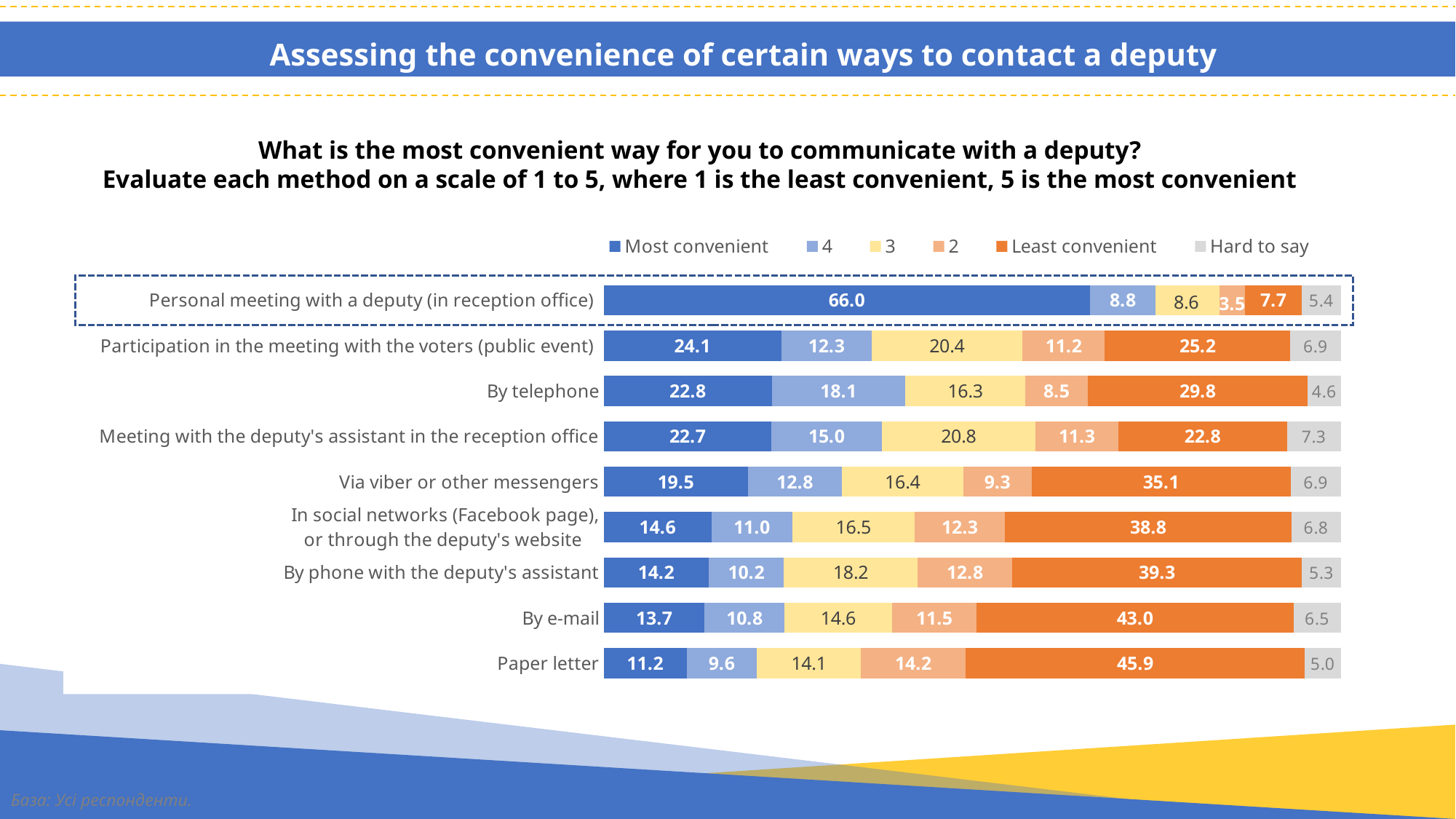
What is the value of the "3" series for "Via viber or other messengers"? 16.4 Which has a larger value for the "4" series: "By telephone" or "Meeting with the deputy's assistant in the reception office"? By telephone What is the "Hard to say" value for "By telephone"? 4.6 How many series does the legend list? 6 What kind of chart is shown on the slide? Stacked bar chart What is the "Most convenient" value for "Personal meeting with a deputy (in reception office)"? 66.0 How many contact methods are shown in the chart? 9 What is the "Least convenient" value for "Paper letter"? 45.9 Which contact method has the highest "Most convenient" value? Personal meeting with a deputy (in reception office) Which contact method has the highest "Least convenient" value? Paper letter Which contact method has the lowest "Most convenient" value? Paper letter What is the difference between the "Most convenient" values for "Personal meeting with a deputy (in reception office)" and "Participation in the meeting with the voters (public event)"? 41.9